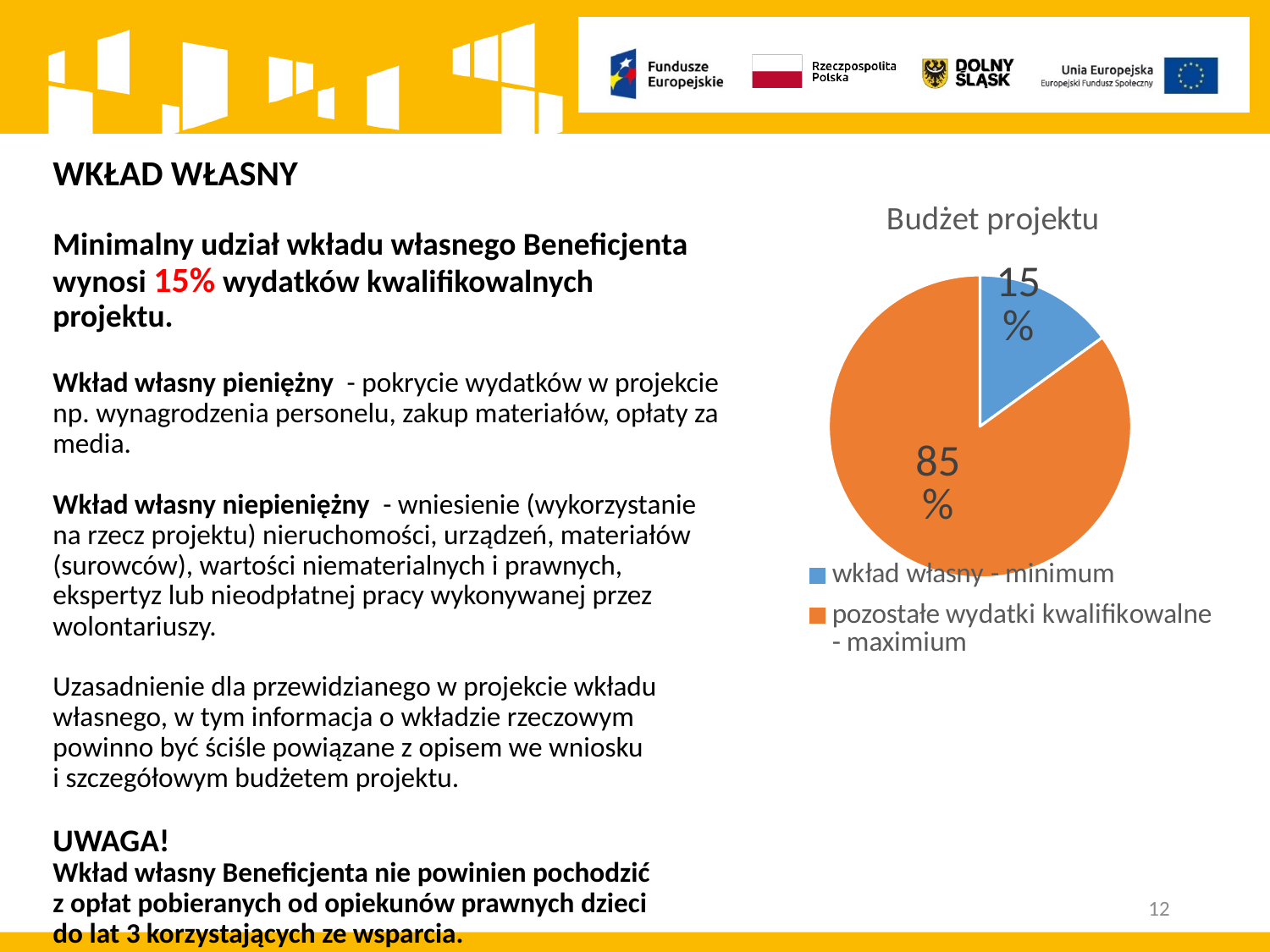
What type of chart is shown on the slide? pie chart What colour is the "wkład własny - minimum" slice? blue Which is larger: the "wkład własny - minimum" slice or the "pozostałe wydatki kwalifikowalne - maximium" slice? pozostałe wydatki kwalifikowalne - maximium How many entries does the chart legend list? 2 What is the total of the two slices shown in the pie chart? 100% What share of the pie does "wkład własny - minimum" represent? 15% What is the difference in percentage points between the "pozostałe wydatki kwalifikowalne - maximium" slice and the "wkład własny - minimum" slice? 70 percentage points What is the title of the chart? Budżet projektu Which slice of the pie is the largest? pozostałe wydatki kwalifikowalne - maximium What share of the pie does "pozostałe wydatki kwalifikowalne - maximium" represent? 85% Which slice of the pie is the smallest? wkład własny - minimum How many slices does the pie chart have? 2